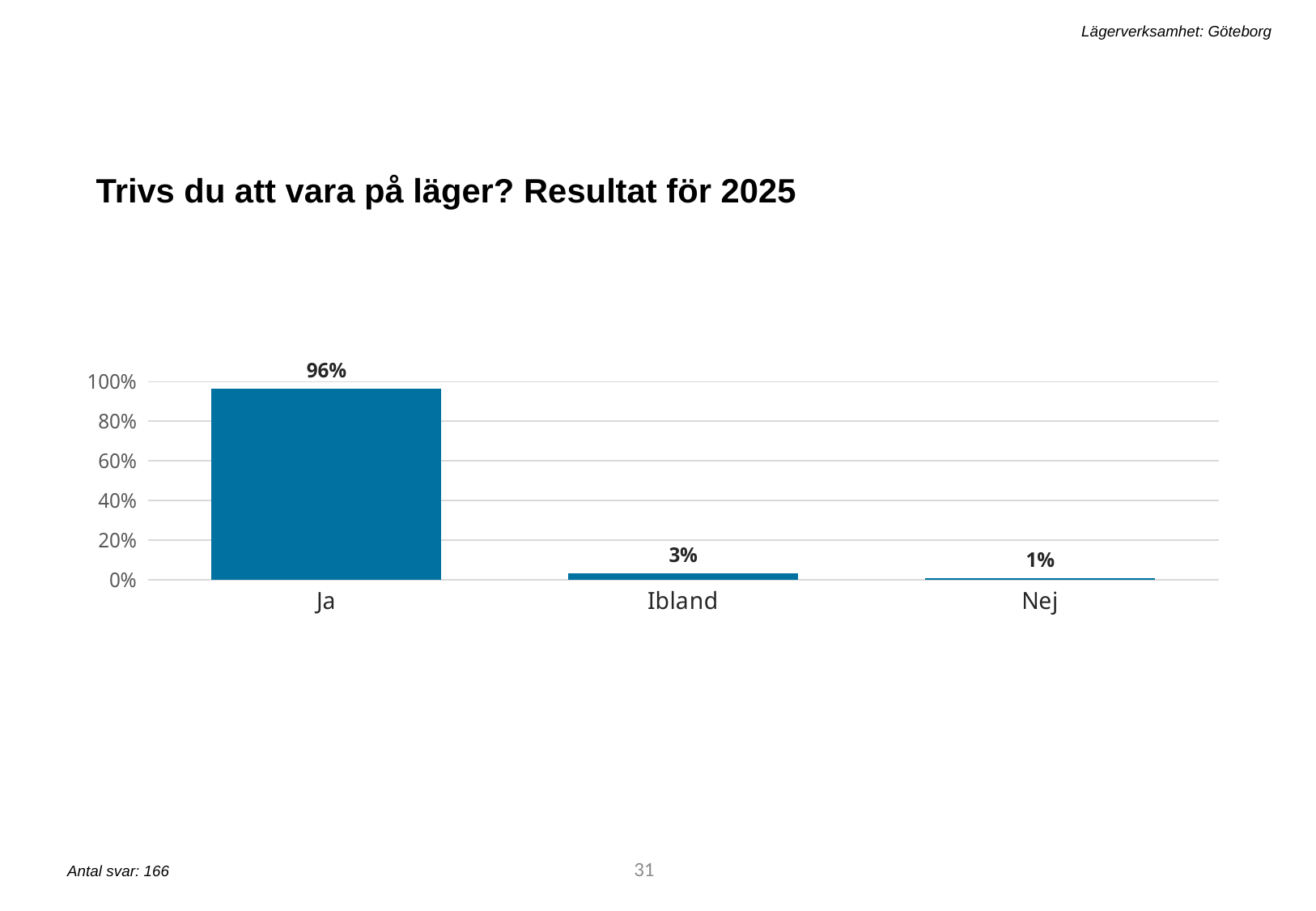
Which is larger, the value for Ibland or the value for Nej? Ibland Which category has the highest value? Ja Which category has the lowest value? Nej What is the difference between the values for Ibland and Nej? 2% How many categories are shown on the x axis? 3 What is the value for Nej? 1% What is the value for Ja? 96% What is the title of the slide? Trivs du att vara på läger? Resultat för 2025 What is the value for Ibland? 3% Is the value for Ja greater or less than 80%? greater What kind of chart is shown on the slide? bar chart What is the difference between the values for Ja and Ibland? 93%